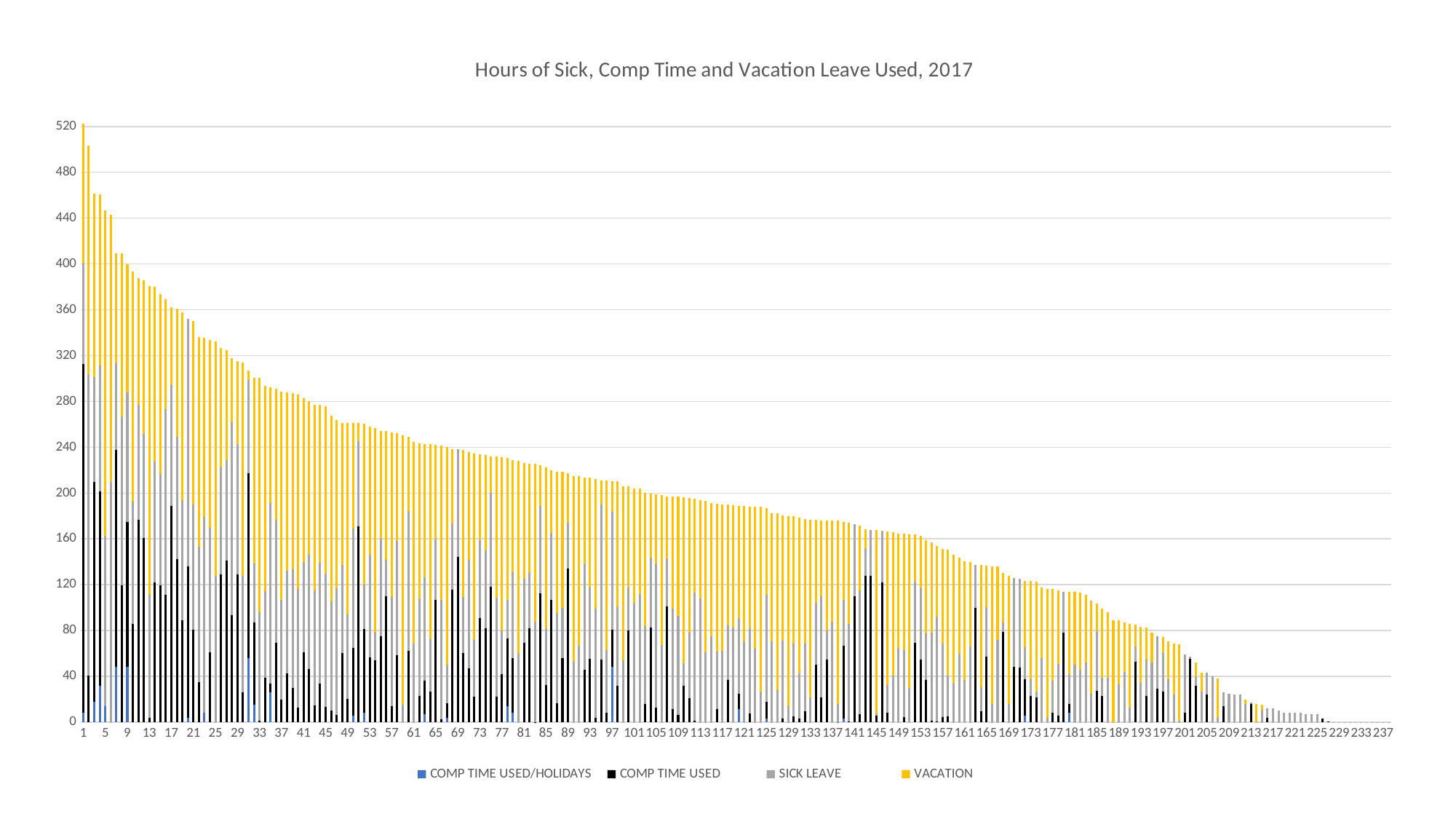
Which has the larger total bar, category 5 or category 205? Category 5 Which category has the highest total bar? 1 Which colour represents VACATION in the chart? Yellow Is the total value for category 61 greater or less than 200? greater Is the total value for category 201 greater or less than 80? less Is the total value for category 101 greater or less than 160? greater What is the title of the chart? Hours of Sick, Comp Time and Vacation Leave Used, 2017 How many series does the legend list? 4 What kind of chart is shown on the slide? Stacked bar chart Do the total bar heights rise or fall moving from left to right along the x axis? Fall